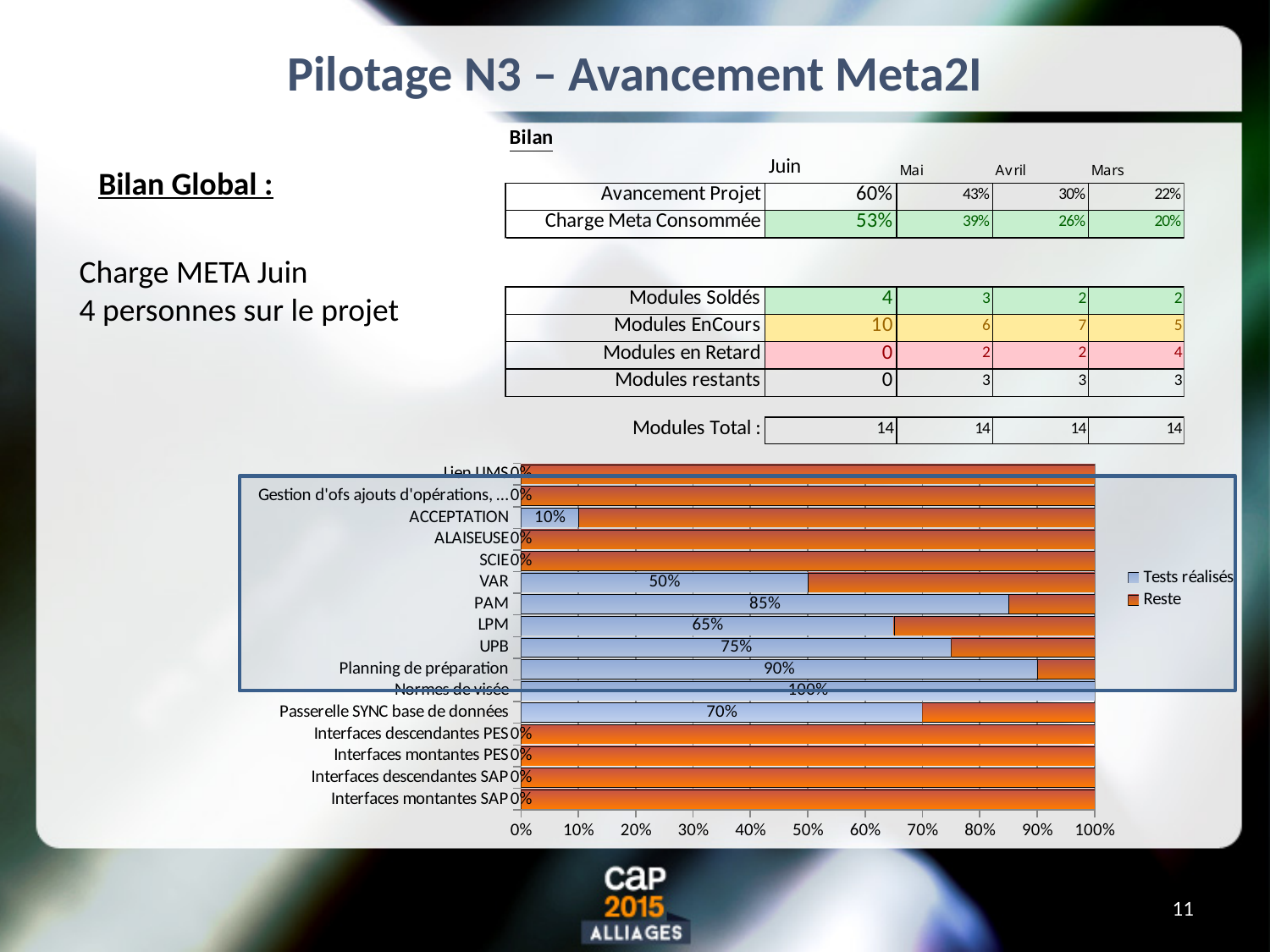
What is the Tests réalisés value for VAR? 50% What is the Tests réalisés value for Passerelle SYNC base de données? 70% Which has a larger Tests réalisés value, LPM or UPB? UPB What is the Tests réalisés value for Planning de préparation? 90% What is the Tests réalisés value for ACCEPTATION? 10% What is the difference between the Tests réalisés values for PAM and VAR? 35% Is the Reste value for VAR greater or less than 40%? greater What is the Tests réalisés value for PAM? 85% How many series does the chart legend list? 2 Which category has the highest Tests réalisés value? Normes de visée How many categories are shown on the bar chart? 16 What kind of chart is shown on the slide? Stacked bar chart